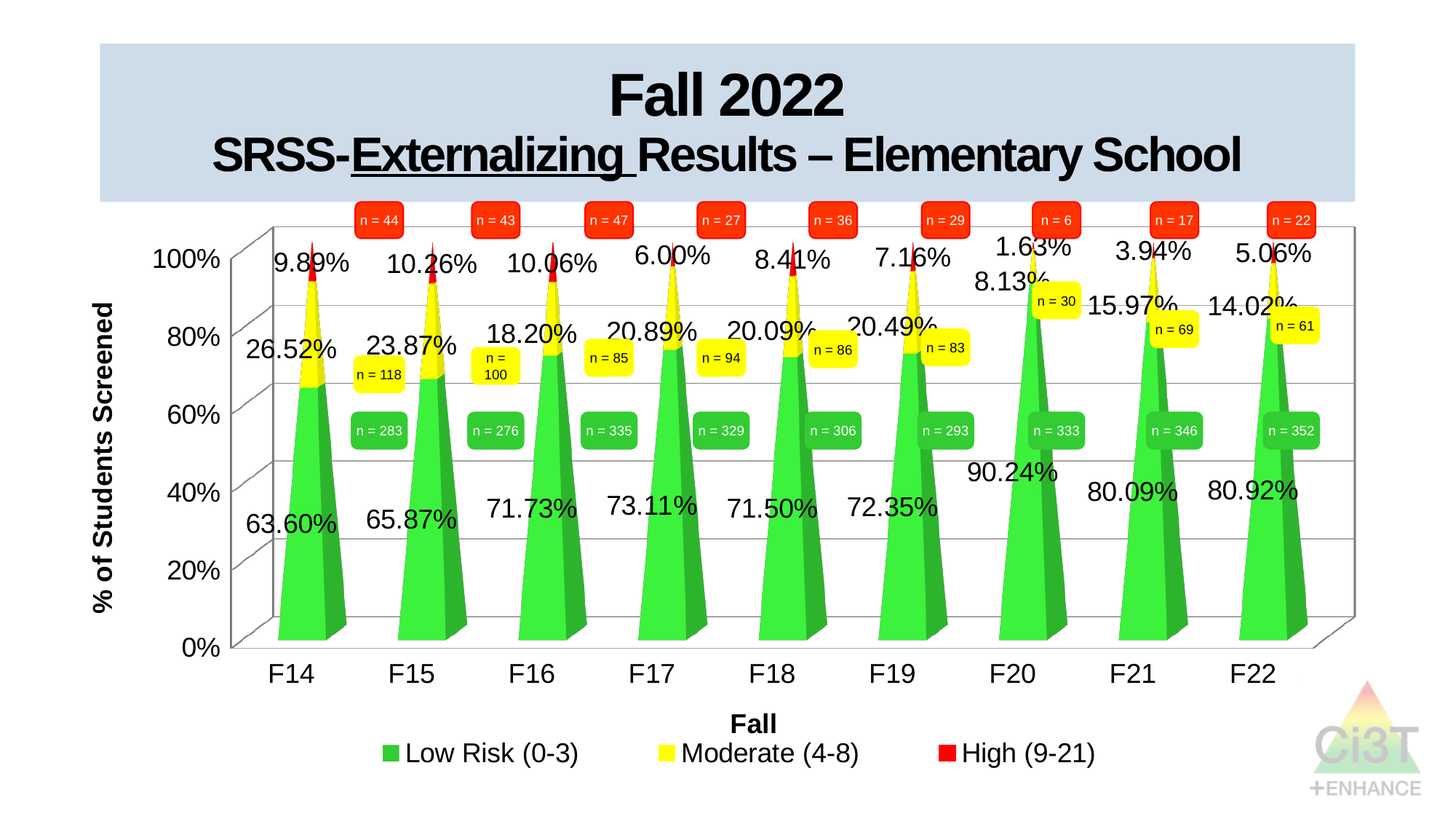
Which fall had the highest Low Risk (0-3) percentage? F20 What percentage of students were Low Risk (0-3) in F14? 63.60% What percentage of students were in the High (9-21) category in F17? 6.00% What is the difference between the Low Risk (0-3) percentage in F22 and in F21? 0.83 percentage points What kind of chart is shown on the slide? Stacked bar chart Which fall had the lowest High (9-21) percentage? F20 What is the title of the slide? Fall 2022 SRSS-Externalizing Results – Elementary School Which is larger, the Moderate (4-8) percentage in F14 or in F15? F14 How many fall screening periods are shown on the x axis? 9 How many series does the legend list? 3 How many students were in the Low Risk (0-3) group in F21 (the n value)? n = 346 What percentage of students were Moderate (4-8) in F22? 14.02%